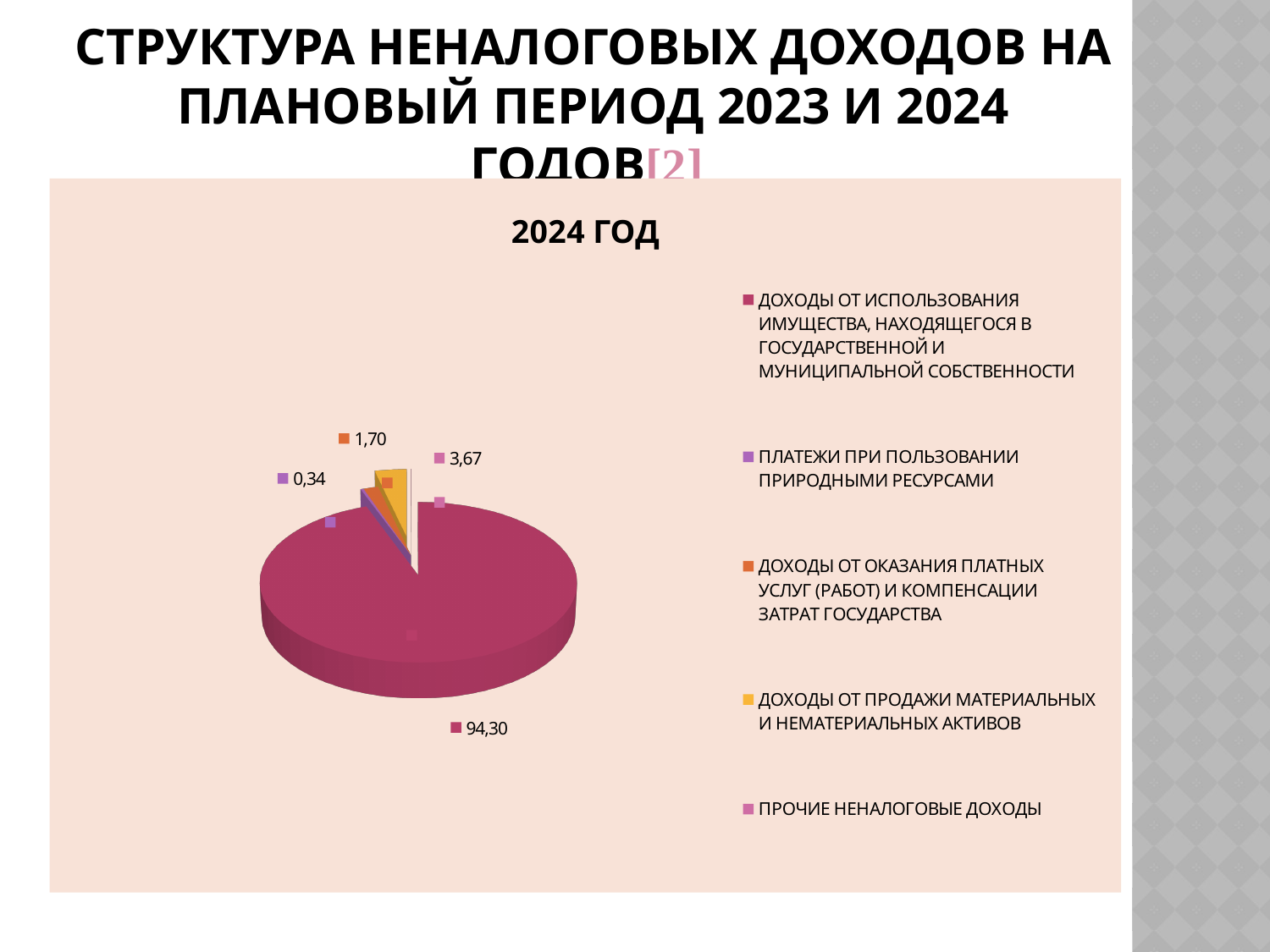
What is the title of the chart? 2024 ГОД How many categories does the chart's legend list? 5 What is the difference between the value for ДОХОДЫ ОТ ИСПОЛЬЗОВАНИЯ ИМУЩЕСТВА (94,30) and the value for ДОХОДЫ ОТ ОКАЗАНИЯ ПЛАТНЫХ УСЛУГ (1,70)? 92,60 What is the value shown for ПЛАТЕЖИ ПРИ ПОЛЬЗОВАНИИ ПРИРОДНЫМИ РЕСУРСАМИ? 0,34 What is the difference between the value for ДОХОДЫ ОТ ОКАЗАНИЯ ПЛАТНЫХ УСЛУГ (1,70) and the value for ПЛАТЕЖИ ПРИ ПОЛЬЗОВАНИИ ПРИРОДНЫМИ РЕСУРСАМИ (0,34)? 1,36 What is the value shown for ДОХОДЫ ОТ ОКАЗАНИЯ ПЛАТНЫХ УСЛУГ (РАБОТ) И КОМПЕНСАЦИИ ЗАТРАТ ГОСУДАРСТВА? 1,70 What is the value shown for ДОХОДЫ ОТ ИСПОЛЬЗОВАНИЯ ИМУЩЕСТВА, НАХОДЯЩЕГОСЯ В ГОСУДАРСТВЕННОЙ И МУНИЦИПАЛЬНОЙ СОБСТВЕННОСТИ? 94,30 What colour is the largest slice of the pie? Magenta What kind of chart is shown on the slide? Pie chart Which category has the largest slice of the pie? ДОХОДЫ ОТ ИСПОЛЬЗОВАНИЯ ИМУЩЕСТВА, НАХОДЯЩЕГОСЯ В ГОСУДАРСТВЕННОЙ И МУНИЦИПАЛЬНОЙ СОБСТВЕННОСТИ Which is larger: the value for ДОХОДЫ ОТ ОКАЗАНИЯ ПЛАТНЫХ УСЛУГ (РАБОТ) И КОМПЕНСАЦИИ ЗАТРАТ ГОСУДАРСТВА or for ПЛАТЕЖИ ПРИ ПОЛЬЗОВАНИИ ПРИРОДНЫМИ РЕСУРСАМИ? ДОХОДЫ ОТ ОКАЗАНИЯ ПЛАТНЫХ УСЛУГ (РАБОТ) И КОМПЕНСАЦИИ ЗАТРАТ ГОСУДАРСТВА